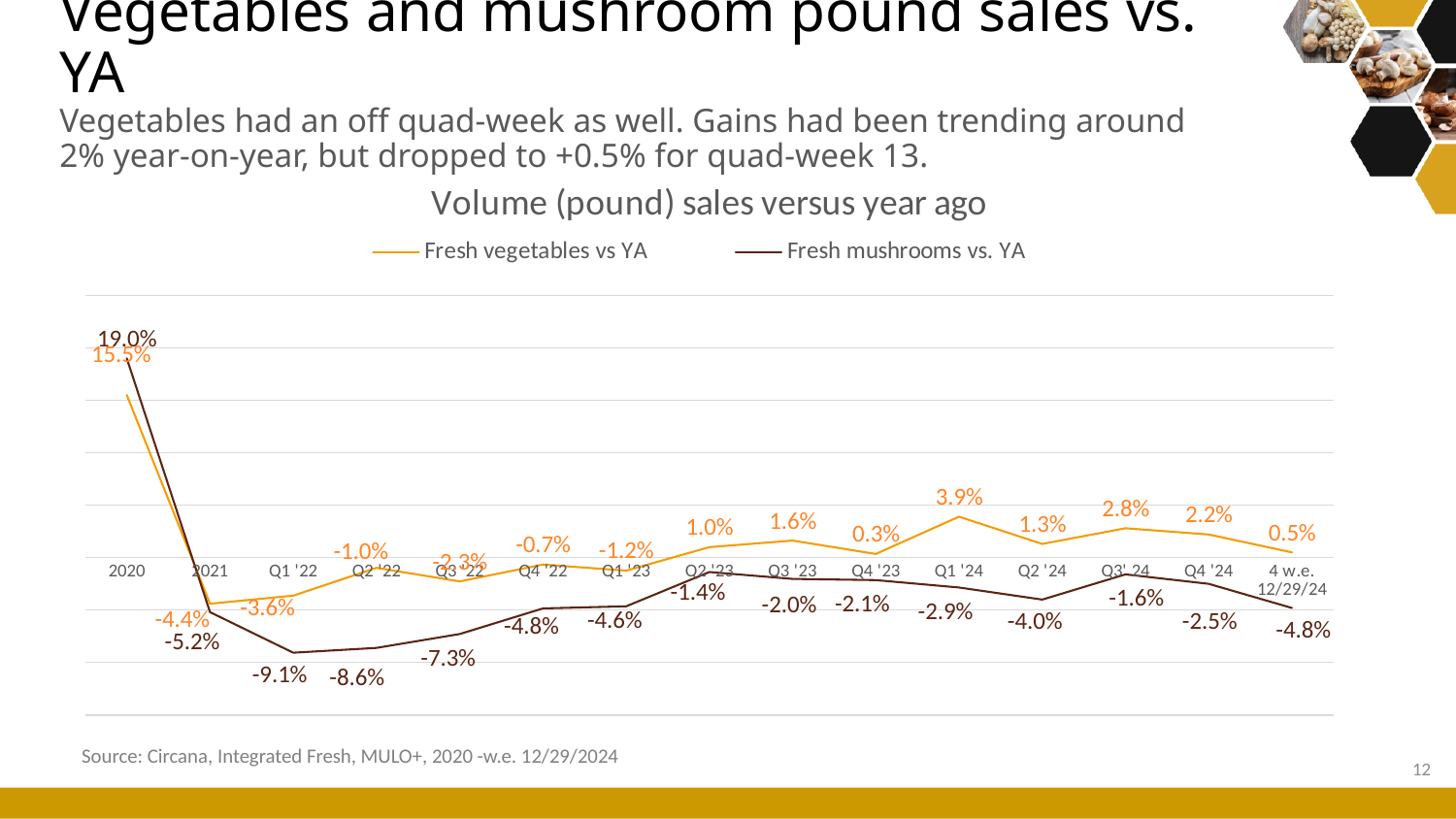
What is the value for Fresh vegetables vs YA for the 4 w.e. 12/29/24 period? 0.5% Which period has the highest value for Fresh vegetables vs YA? 2020 How many series does the legend list? 2 What is the value for Fresh vegetables vs YA in Q1 '24? 3.9% What type of chart is shown on the slide? Line chart Which series has the higher value in Q2 '24, Fresh vegetables vs YA or Fresh mushrooms vs. YA? Fresh vegetables vs YA How many periods are plotted along the x axis? 15 Which period has the lowest value for Fresh mushrooms vs. YA? Q1 '22 What is the difference between Fresh vegetables vs YA and Fresh mushrooms vs. YA for the 4 w.e. 12/29/24 period? 5.3 percentage points What is the title of the chart? Volume (pound) sales versus year ago What is the value for Fresh mushrooms vs. YA in Q1 '22? -9.1% What is the value for Fresh mushrooms vs. YA in 2020? 19.0%